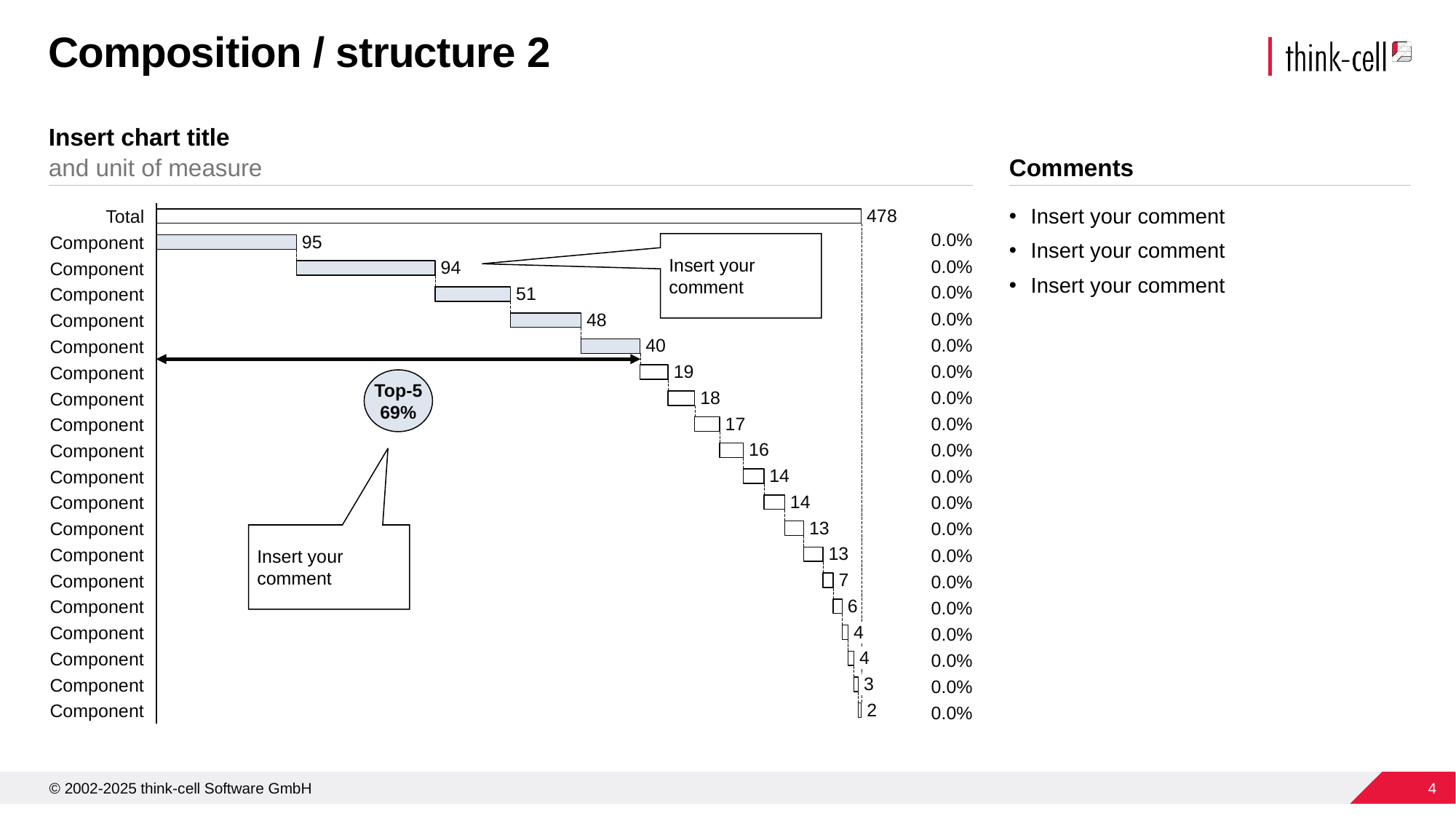
Which is larger: the first component bar or the third component bar? the first component bar What is the sum of the five largest component values (95, 94, 51, 48, 40)? 328 What is the value of the largest component bar? 95 Do the component values increase or decrease going down the chart? decrease What is the difference between the Total value and the largest component value? 383 What percentage value is printed at the right of each component row? 0.0% What share of the total do the Top-5 components represent, according to the circle label? 69% What is the difference between the first component bar (95) and the second component bar (94)? 1 What kind of chart is shown on the slide? bar chart What is the value of the smallest component bar? 2 What is the value shown for the Total bar? 478 How many component bars are shown below the Total bar? 19